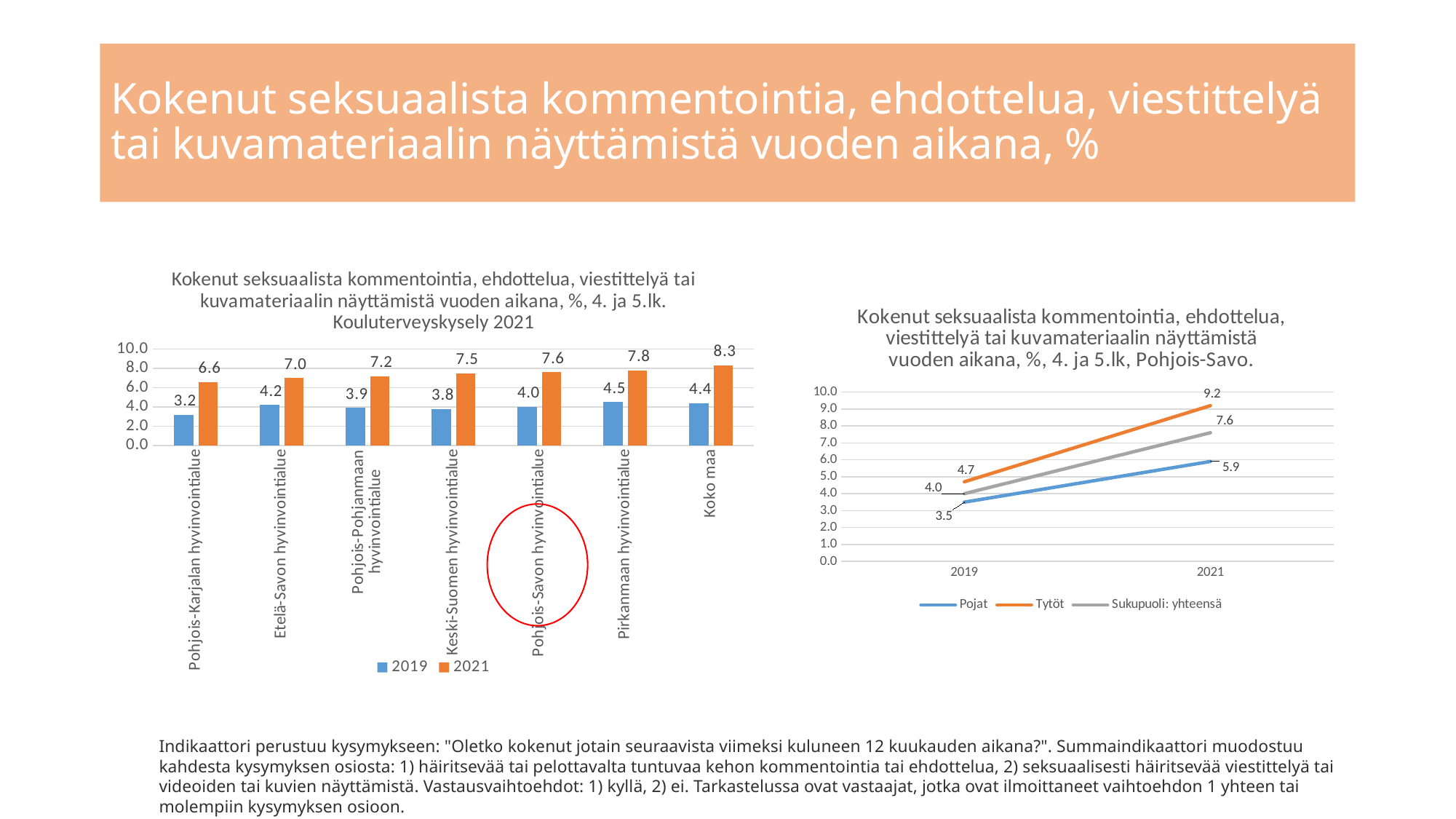
In the left bar chart, which category has the lowest 2019 value? Pohjois-Karjalan hyvinvointialue What type of chart is the chart on the left? bar chart In the left bar chart, what is the 2019 value for Pohjois-Karjalan hyvinvointialue? 3.2 How many categories are shown on the x axis of the left bar chart? 7 In the left bar chart, which category has the highest 2021 value? Koko maa In the right line chart (Pohjois-Savo), what is the 2019 value for Pojat? 3.5 How many series does the legend of the right line chart list? 3 In the right line chart (Pohjois-Savo), do the values for Sukupuoli: yhteensä rise or fall from 2019 to 2021? rise In the left bar chart, what is the 2021 value for Pohjois-Savon hyvinvointialue? 7.6 In the left bar chart, which is larger: the 2019 value for Pirkanmaan hyvinvointialue or the 2019 value for Keski-Suomen hyvinvointialue? Pirkanmaan hyvinvointialue In the left bar chart, what is the difference between the 2021 and 2019 values for Koko maa? 3.9 In the right line chart (Pohjois-Savo), what is the 2021 value for Tytöt? 9.2